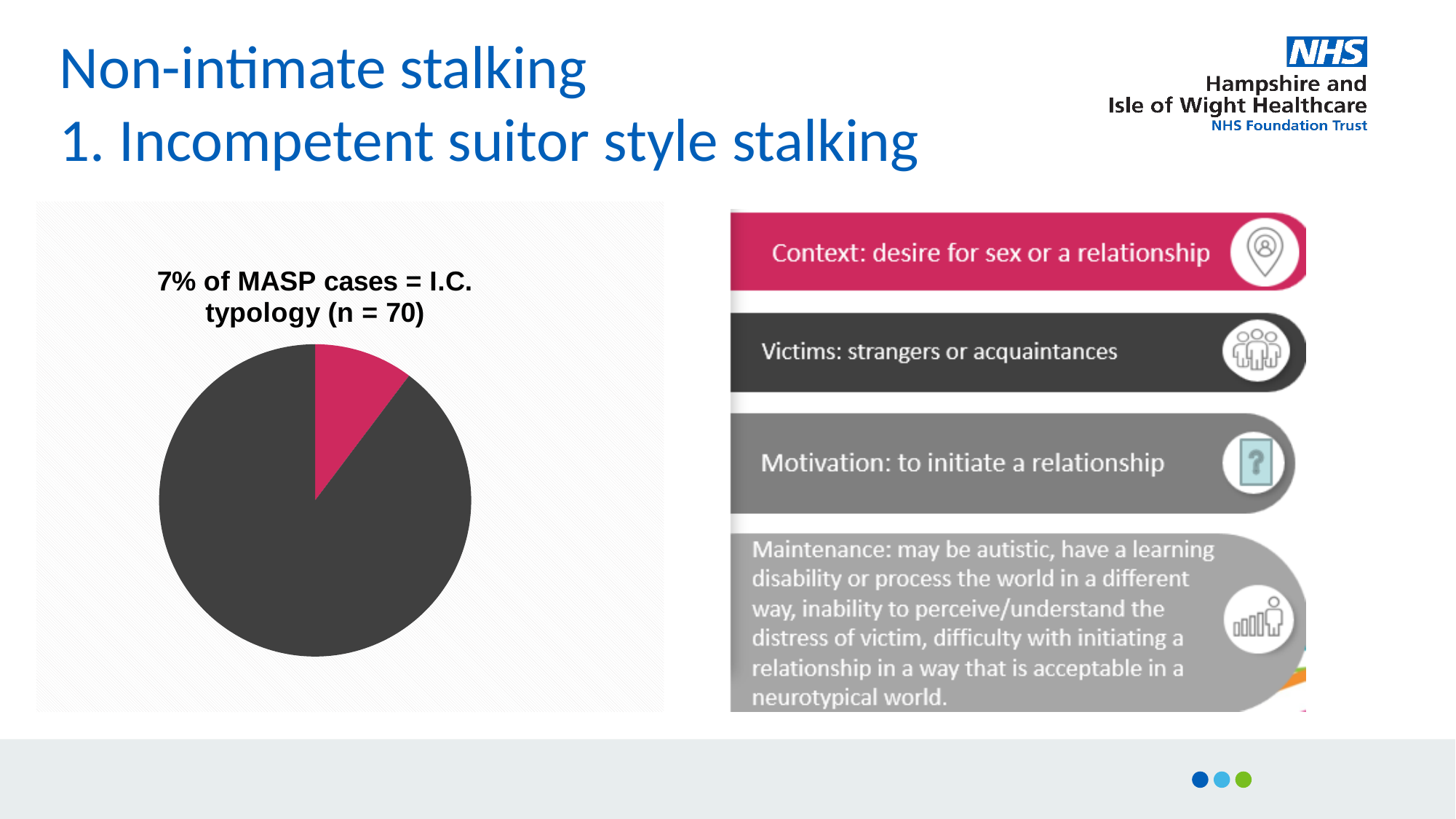
Which slice of the pie chart is larger, the dark grey slice or the pink slice? Dark grey Which slice of the pie chart is the largest? The dark grey slice How many slices does the pie chart have? 2 What kind of chart is shown on the left of the slide? Pie chart According to the pie chart's title, what percentage of MASP cases are I.C. typology? 7% What is the sample size (n) stated in the pie chart's title? 70 Which slice of the pie chart is the smallest? The pink slice What is the title of the pie chart? 7% of MASP cases = I.C. typology (n = 70)